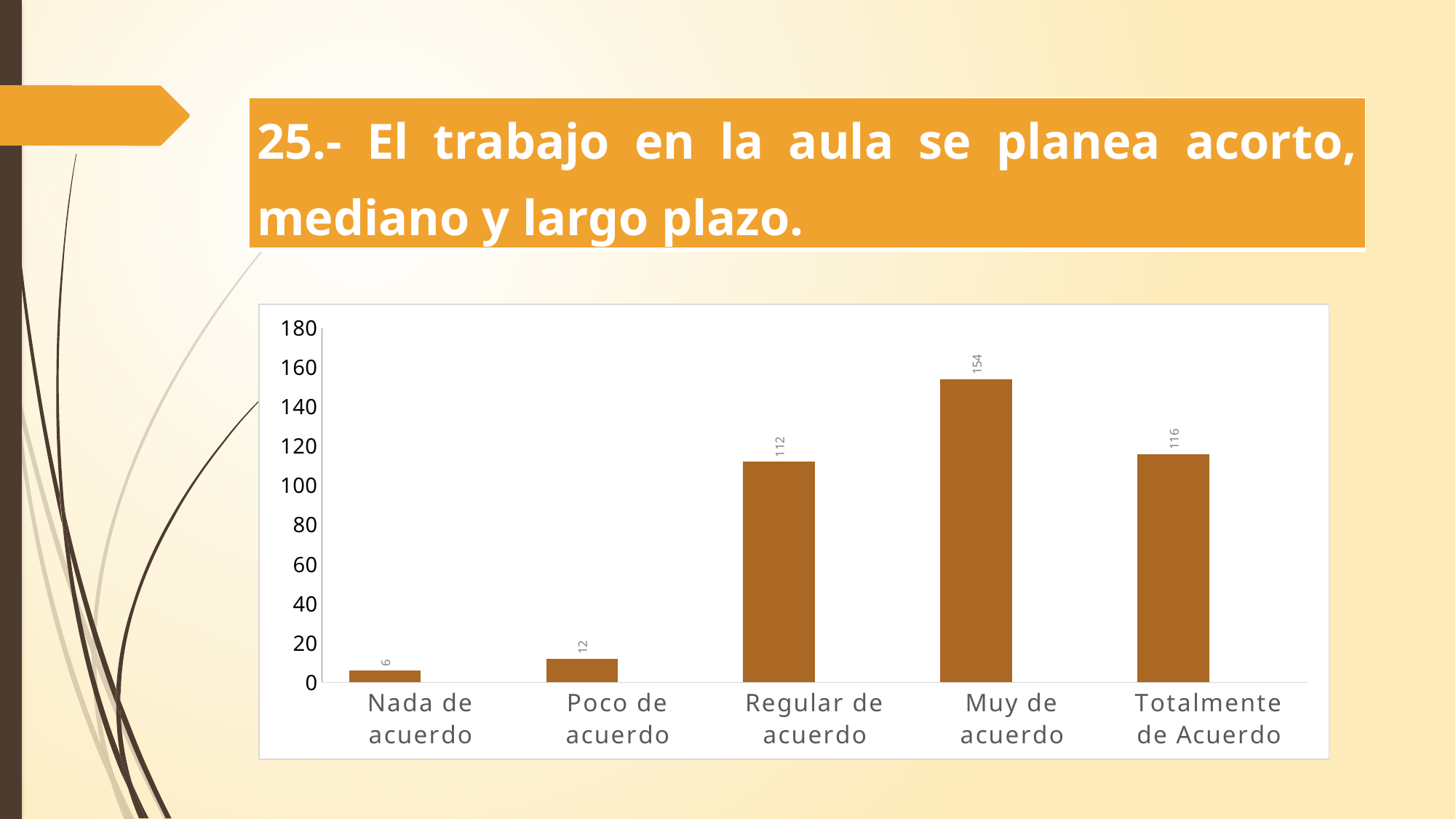
How many categories are shown on the x axis? 5 What is the difference between the values for Muy de acuerdo and Totalmente de Acuerdo? 38 What kind of chart is shown on the slide? bar chart What is the value for Muy de acuerdo? 154 What is the highest value shown on the vertical axis? 180 Is the value for Poco de acuerdo greater or less than 20? less Which is larger, the value for Regular de acuerdo or the value for Totalmente de Acuerdo? Totalmente de Acuerdo Which category has the lowest value? Nada de acuerdo What is the value for Nada de acuerdo? 6 Which category has the highest value? Muy de acuerdo What is the value for Totalmente de Acuerdo? 116 What is the value for Regular de acuerdo? 112